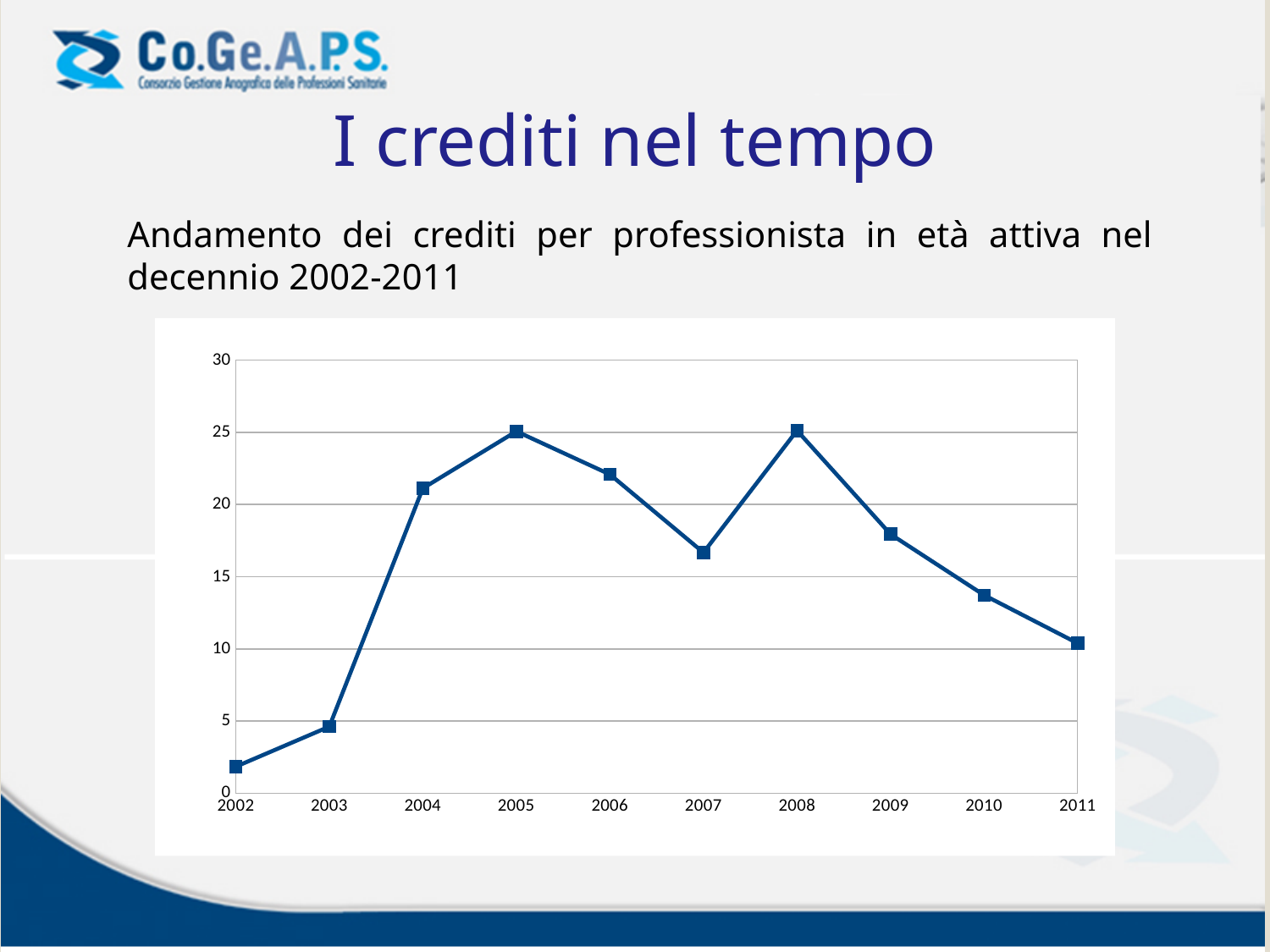
Is the value for 2004 greater or less than 20? greater Is the value for 2009 greater or less than 20? less Which year has the larger value, 2009 or 2010? 2009 Which year has the lowest value in the chart? 2002 Which year has the larger value, 2004 or 2007? 2004 What kind of chart is shown on the slide? line chart Is the value for 2003 greater or less than 5? less Do the values rise or fall from 2008 to 2011? fall How many years are plotted on the x axis of the chart? 10 Do the values rise or fall from 2002 to 2005? rise